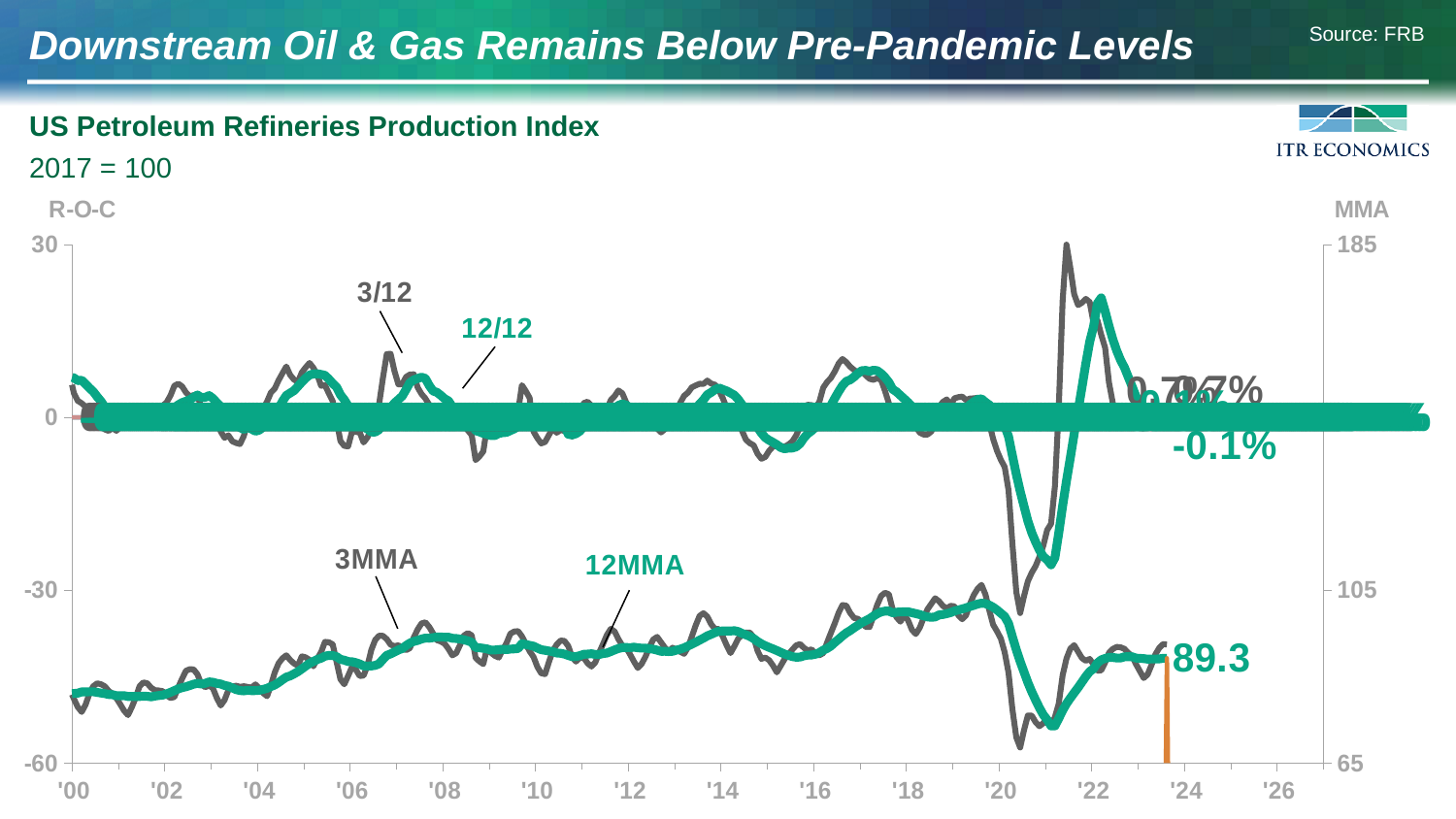
What is the latest value labeled on the 12/12 rate-of-change line? -0.1% Does the 12MMA line generally rise or fall from '00 to '18? rise What is the latest value labeled on the 12MMA line? 89.3 What base year is the index set to 100? 2017 How many labeled series are plotted on the chart? 4 Is the lowest point of the 12/12 line around 2021 greater or less than -30? greater Is the lowest point of the 12MMA line around 2021 greater or less than 65? greater Is the latest 12MMA value of 89.3 greater or less than 105? less What kind of chart is shown on the slide? line chart How many year labels are shown on the x axis? 14 What is the title of the chart? US Petroleum Refineries Production Index Which is higher on the 12MMA line: the value around '18 or the value around '02? '18